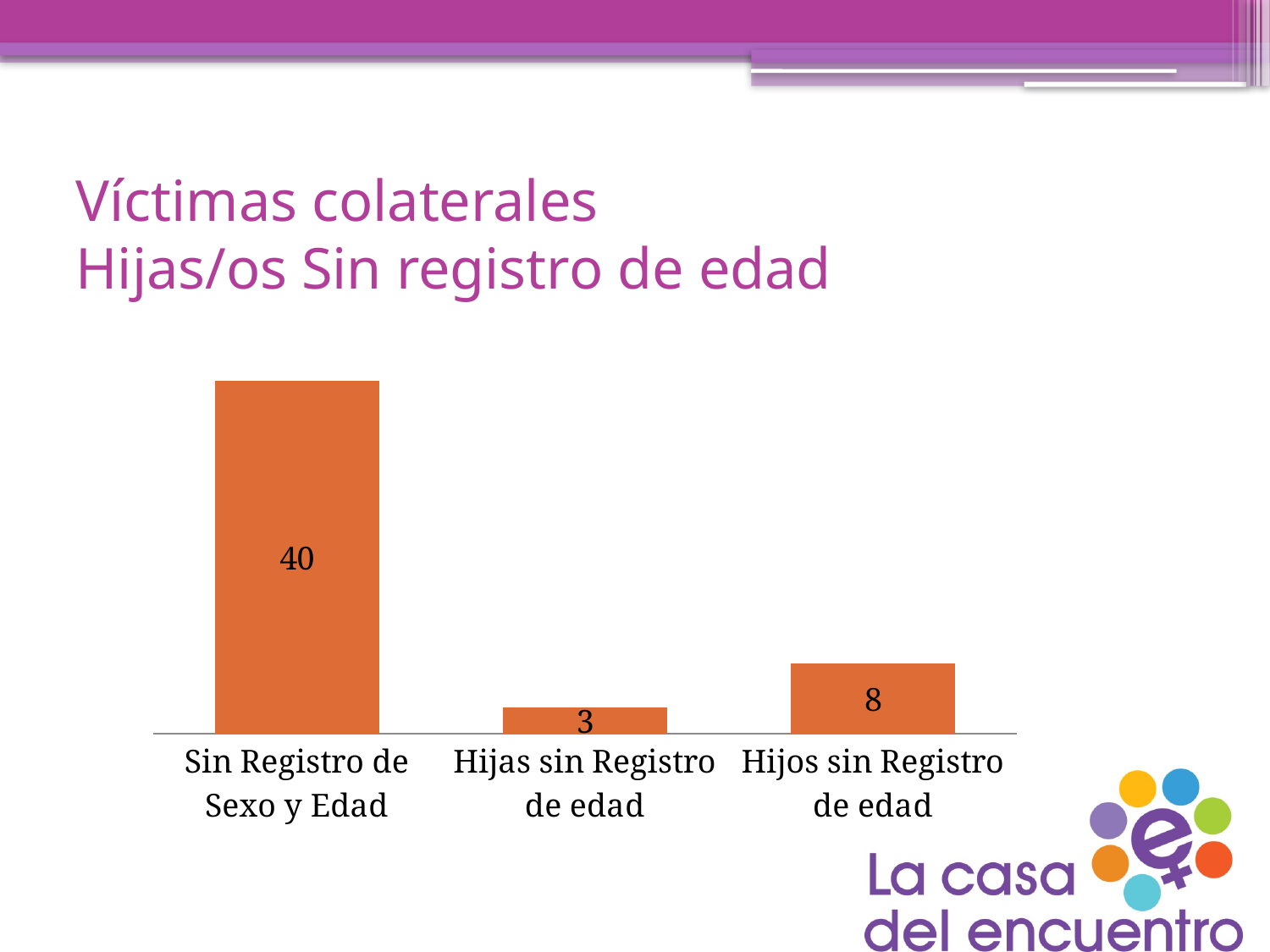
Which is larger, the value for "Hijas sin Registro de edad" or "Hijos sin Registro de edad"? Hijos sin Registro de edad What colour are the bars in the chart? Orange What is the value for "Sin Registro de Sexo y Edad"? 40 What is the difference between the values for "Sin Registro de Sexo y Edad" and "Hijos sin Registro de edad"? 32 Which category has the highest value? Sin Registro de Sexo y Edad What is the total of the three values shown in the chart? 51 What is the difference between the values for "Hijos sin Registro de edad" and "Hijas sin Registro de edad"? 5 What is the value for "Hijos sin Registro de edad"? 8 What is the value for "Hijas sin Registro de edad"? 3 Which category has the lowest value? Hijas sin Registro de edad How many categories are shown in the chart? 3 What kind of chart is shown on the slide? Bar chart